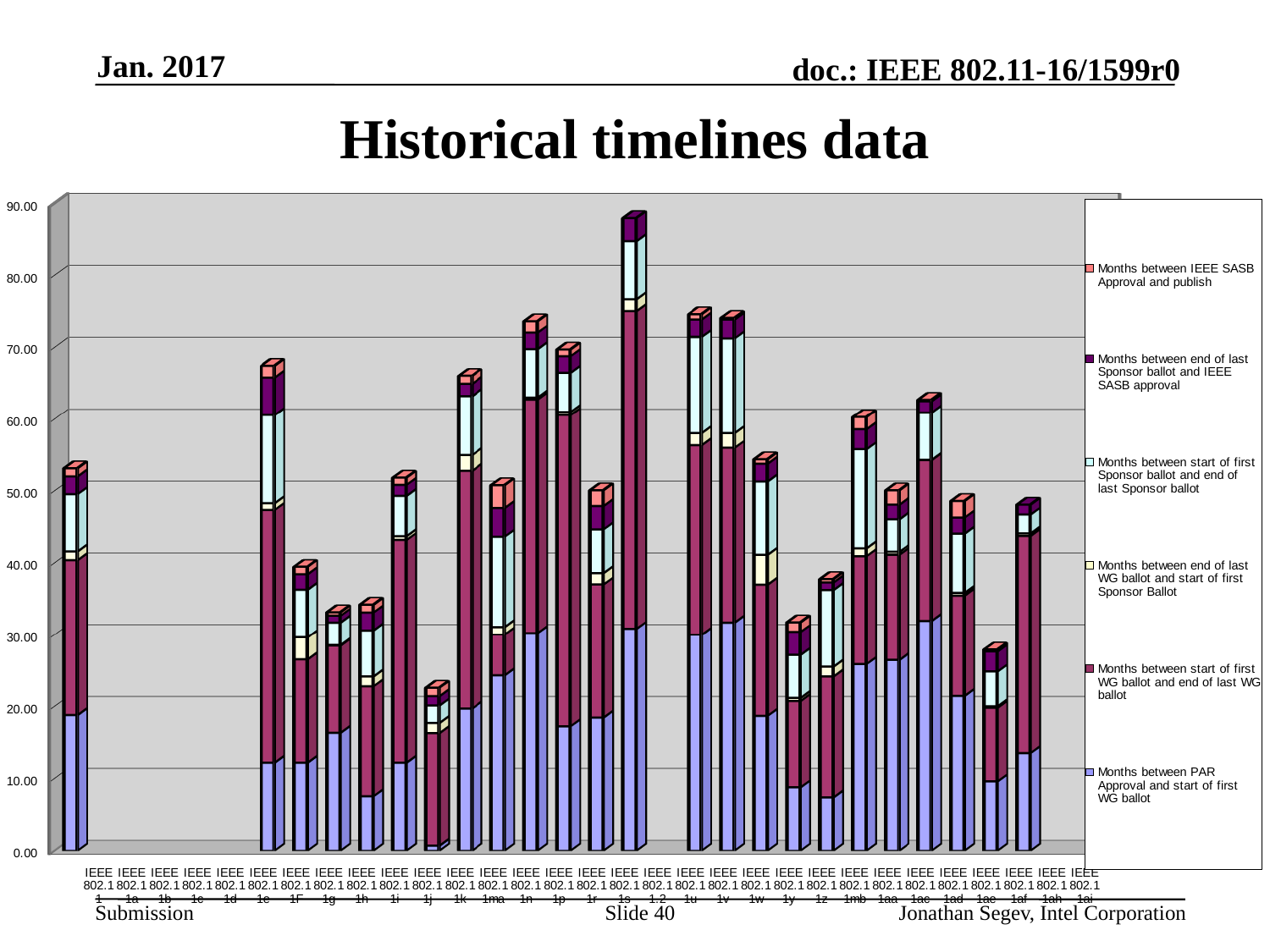
Is the total for IEEE 802.11s greater or less than 80? greater Which has the larger total, IEEE 802.11e or IEEE 802.11F? IEEE 802.11e Among the categories with bars, which has the shortest stacked bar? IEEE 802.11j What kind of chart is shown on the slide? Stacked bar chart Is the total for IEEE 802.11e greater or less than 60? greater Which category has the tallest stacked bar? IEEE 802.11s Which legend entry corresponds to the bottom (light blue) segment of each bar? Months between PAR Approval and start of first WG ballot What is the title of the chart? Historical timelines data Is the total for IEEE 802.11y greater or less than 40? less Which has the larger total, IEEE 802.11u or IEEE 802.11w? IEEE 802.11u How many series does the legend list? 6